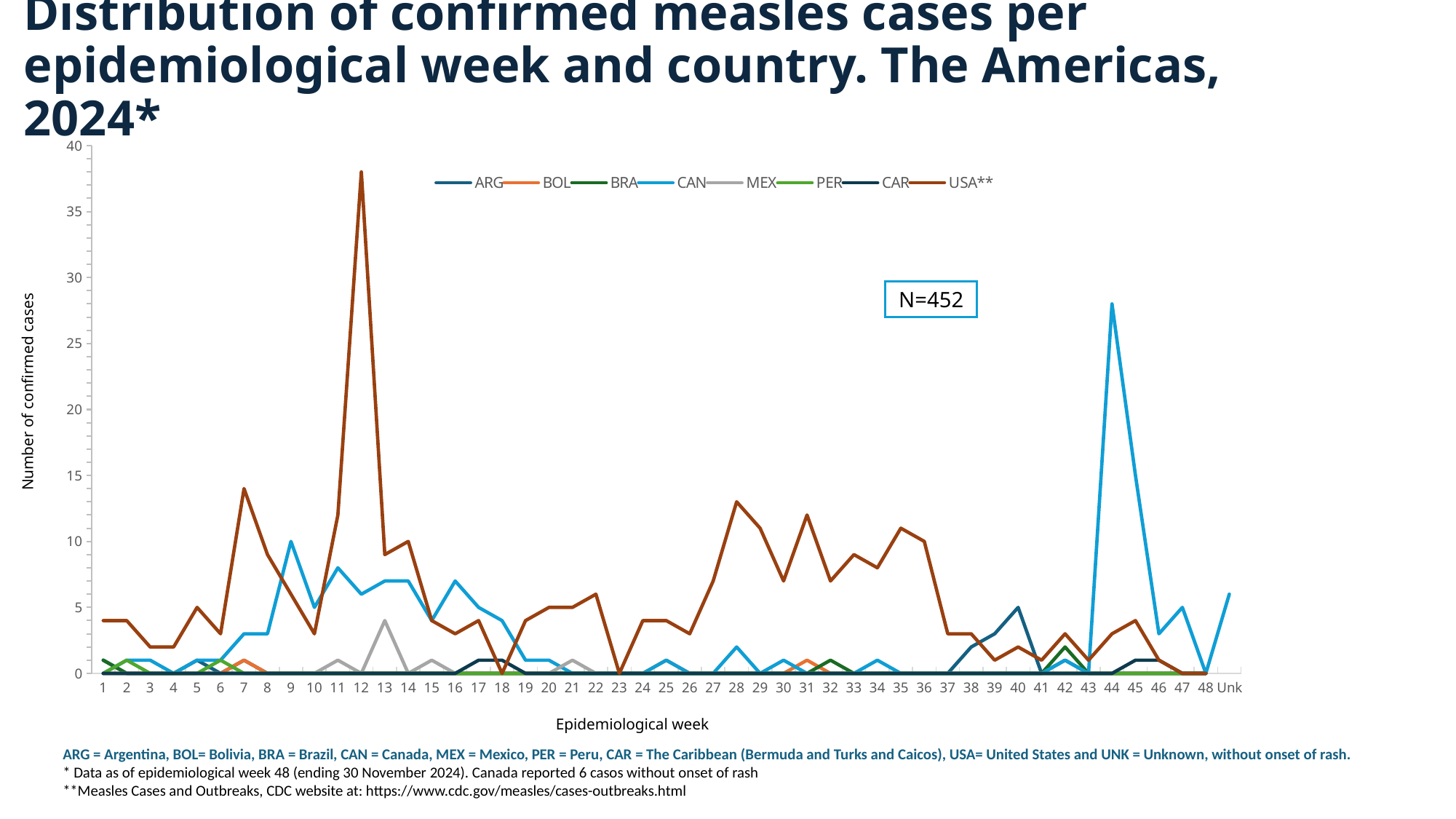
What total N is shown in the box on the chart? N=452 How many series does the legend list? 8 Is the value for USA** in week 28 greater or less than 10? greater What is the label of the y axis? Number of confirmed cases Which is larger: the USA** peak in week 12 or the CAN peak in week 44? USA** peak in week 12 Is the value for USA** in week 12 greater or less than 35? greater In which epidemiological week does the USA** series reach its peak? 12 How many categories are shown along the x axis (epidemiological weeks including Unk)? 49 What kind of chart is shown on the slide? line chart Is the value for CAN in week 44 greater or less than 25? greater Which series reaches the highest value on the chart? USA** In which epidemiological week does the CAN series reach its peak? 44